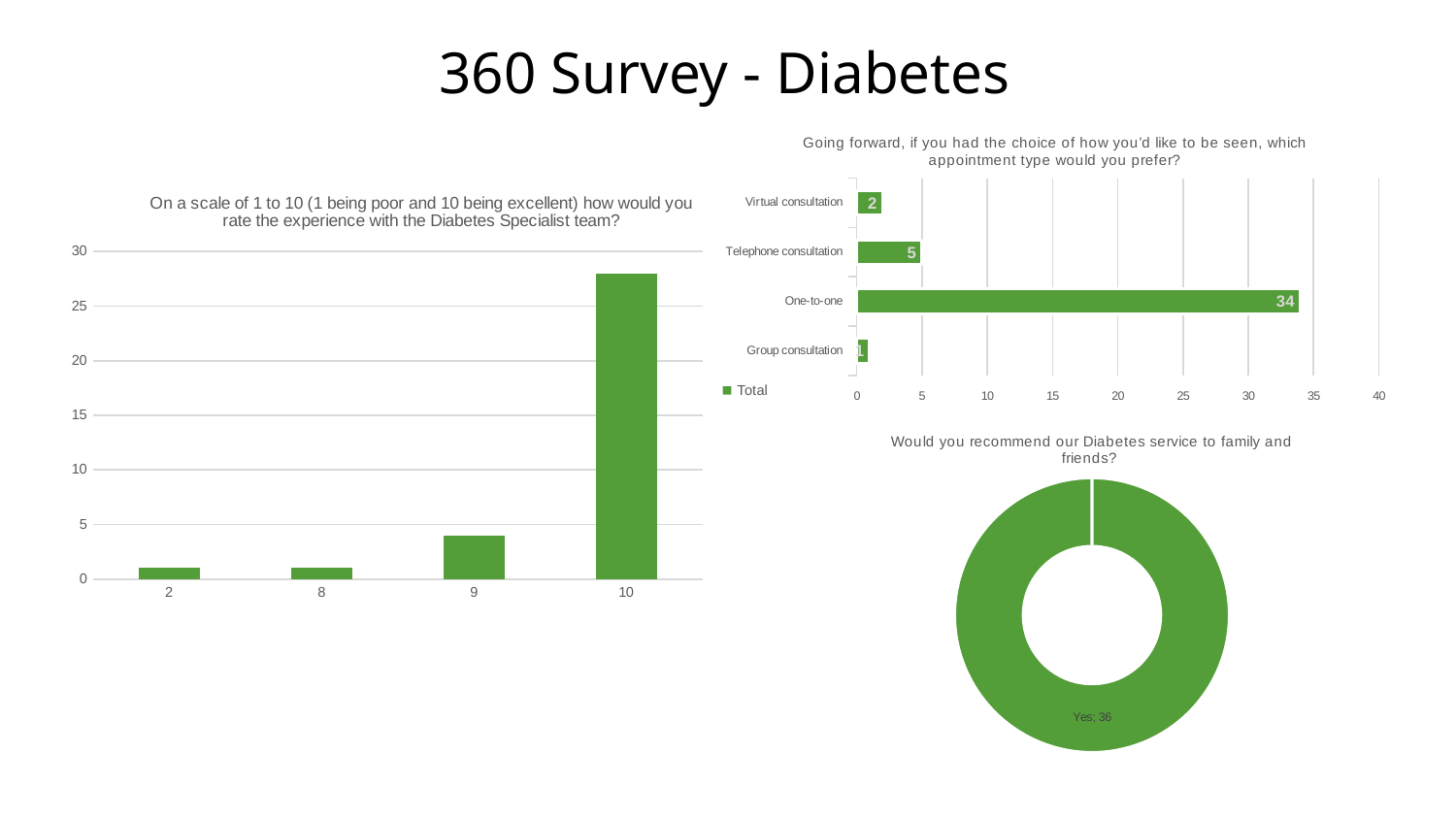
In the chart titled 'Would you recommend our Diabetes service to family and friends?', what value is shown for Yes? 36 In the chart titled 'Going forward, if you had the choice of how you'd like to be seen, which appointment type would you prefer?', what is the value for Telephone consultation? 5 In the chart titled 'Going forward, if you had the choice of how you'd like to be seen, which appointment type would you prefer?', which appointment type has the highest value? One-to-one In the chart titled 'On a scale of 1 to 10 (1 being poor and 10 being excellent) how would you rate the experience with the Diabetes Specialist team?', is the value for rating 10 greater or less than 25? greater In the chart titled 'Going forward, if you had the choice of how you'd like to be seen, which appointment type would you prefer?', what is the difference between the values for One-to-one and Telephone consultation? 29 In the chart titled 'On a scale of 1 to 10 (1 being poor and 10 being excellent) how would you rate the experience with the Diabetes Specialist team?', is the value for rating 9 greater or less than 5? less What kind of chart is the one titled 'On a scale of 1 to 10 (1 being poor and 10 being excellent) how would you rate the experience with the Diabetes Specialist team?'? Bar chart In the chart titled 'Going forward, if you had the choice of how you'd like to be seen, which appointment type would you prefer?', what is the value for One-to-one? 34 In the chart titled 'Going forward, if you had the choice of how you'd like to be seen, which appointment type would you prefer?', what is the value for Virtual consultation? 2 In the chart titled 'On a scale of 1 to 10 (1 being poor and 10 being excellent) how would you rate the experience with the Diabetes Specialist team?', which rating has the highest bar? 10 In the chart titled 'Going forward, if you had the choice of how you'd like to be seen, which appointment type would you prefer?', how many appointment types are shown? 4